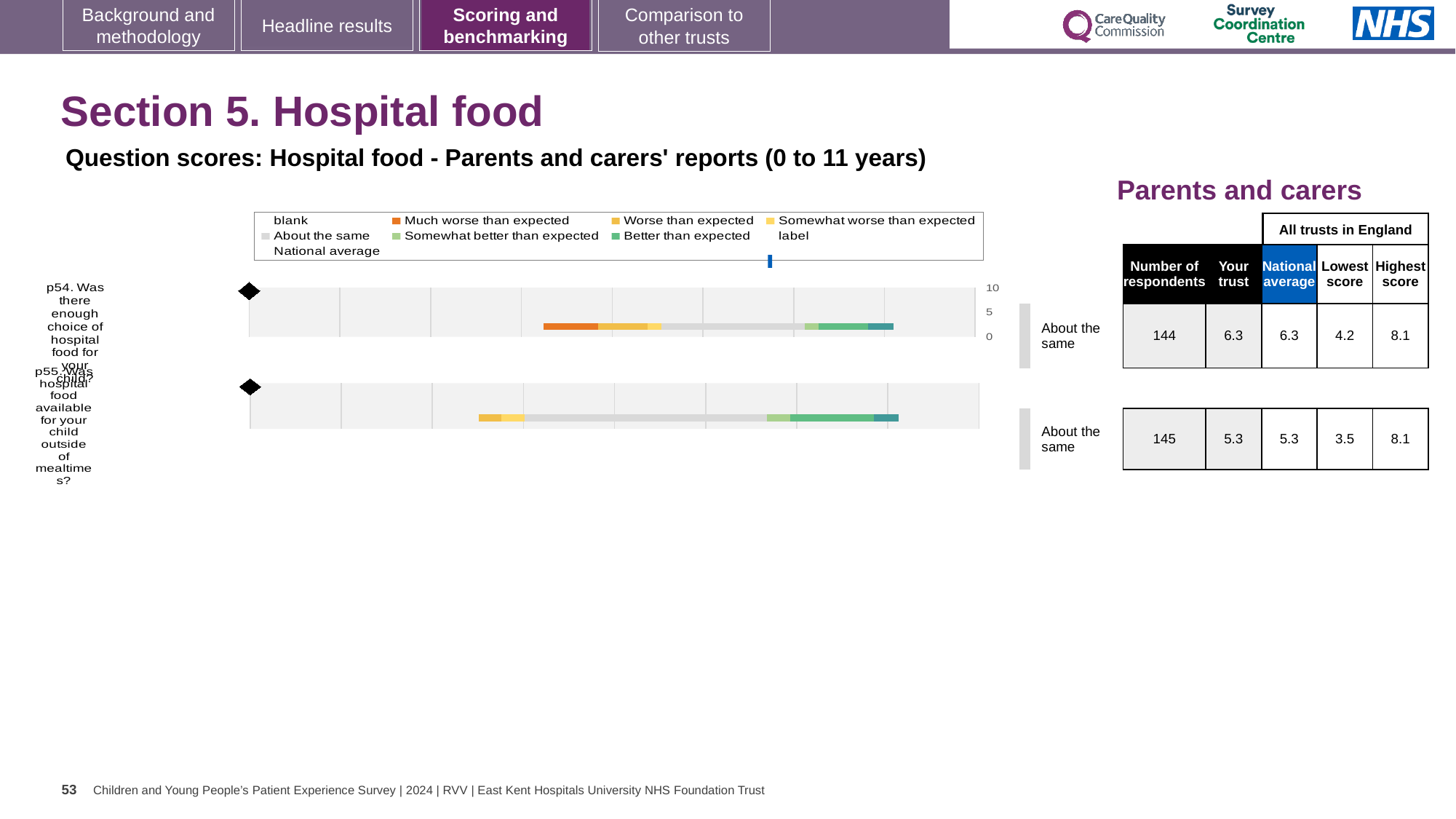
What kind of chart is used to show the question scores for hospital food? bar chart Which question has the higher 'Your trust' score, p54 or p55? p54 What benchmark category is the trust's result for p54 placed in? About the same Which legend entry in the hospital food chart is shown in dark blue? National average How many respondents answered p55 (hospital food available outside of mealtimes)? 145 What is the difference between the highest score and the lowest score for p55? 4.6 In the chart legend, what colour represents 'Much worse than expected'? orange What is the 'Your trust' score for p54 (enough choice of hospital food)? 6.3 What is the difference between the highest score and the lowest score for p54? 3.9 What is the national average score for p55? 5.3 How many entries does the legend of the hospital food chart list? 9 How many questions (categories) are plotted in the hospital food chart? 2